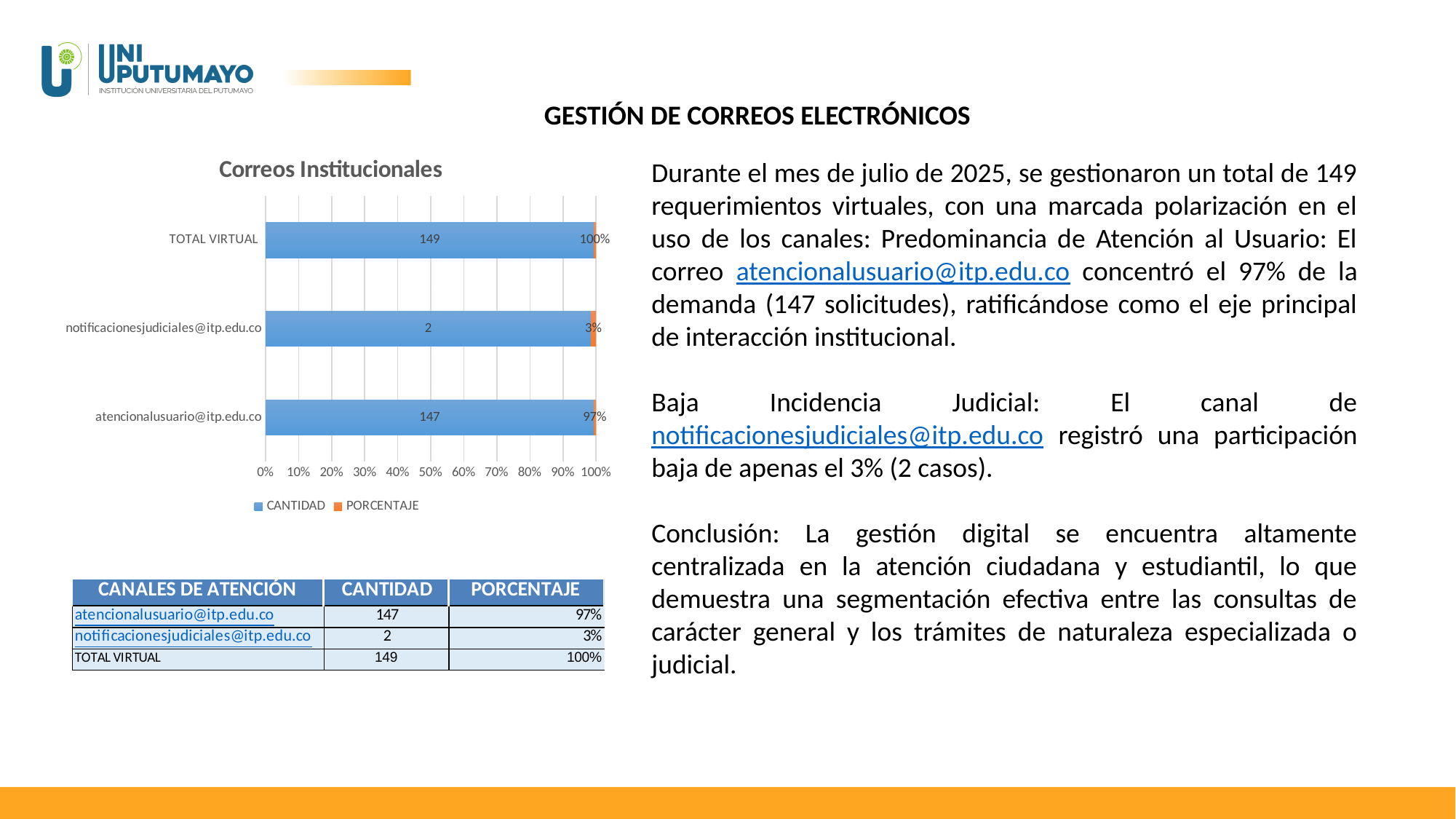
What is the CANTIDAD value for atencionalusuario@itp.edu.co in the chart? 147 What are the two series named in the chart legend? CANTIDAD and PORCENTAJE What is the difference in CANTIDAD between atencionalusuario@itp.edu.co and notificacionesjudiciales@itp.edu.co? 145 What type of chart is shown on the slide? bar chart Which has a larger PORCENTAJE value, atencionalusuario@itp.edu.co or notificacionesjudiciales@itp.edu.co? atencionalusuario@itp.edu.co Which email channel has the lowest CANTIDAD value in the chart? notificacionesjudiciales@itp.edu.co What is the PORCENTAJE value for notificacionesjudiciales@itp.edu.co in the chart? 3% How many series does the chart legend list? 2 How many categories are shown on the chart's vertical axis? 3 What is the CANTIDAD value for TOTAL VIRTUAL in the chart? 149 What is the PORCENTAJE value for atencionalusuario@itp.edu.co in the chart? 97% What is the title of the chart on the slide? Correos Institucionales